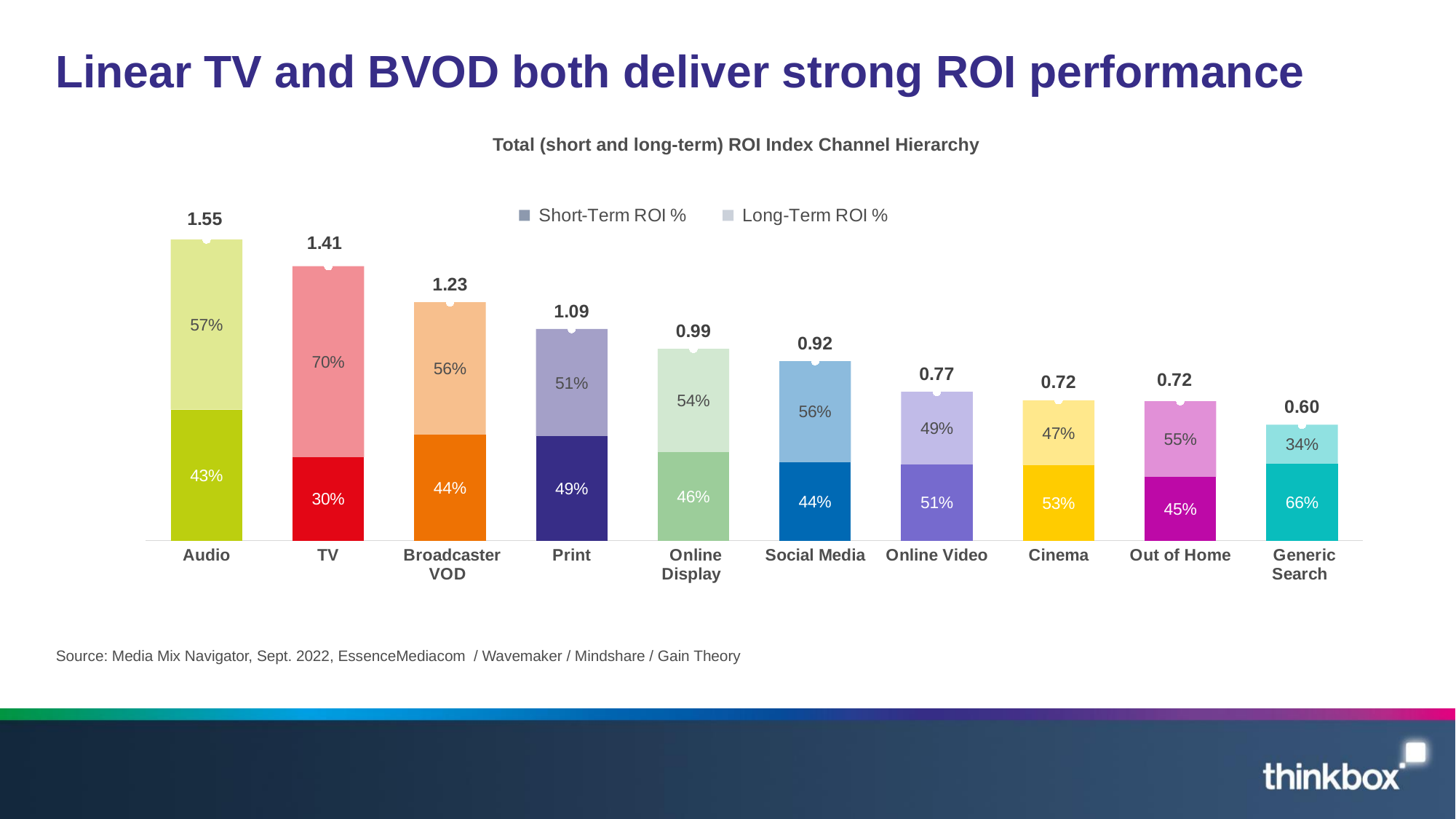
How many series does the legend list? 2 What is the Short-Term ROI % label shown for TV? 30% What is the total ROI index shown above the Audio bar? 1.55 Which has a higher total ROI index, Print or Social Media? Print What is the Short-Term ROI % label shown for Generic Search? 66% What is the difference between the total ROI index for Audio and for TV? 0.14 What kind of chart is shown on the slide? Stacked bar chart Which channel has the highest total ROI index? Audio What is the title of the chart? Total (short and long-term) ROI Index Channel Hierarchy Which channel has the lowest total ROI index? Generic Search How many channels are shown on the x axis? 10 What is the Long-Term ROI % label shown for Broadcaster VOD? 56%